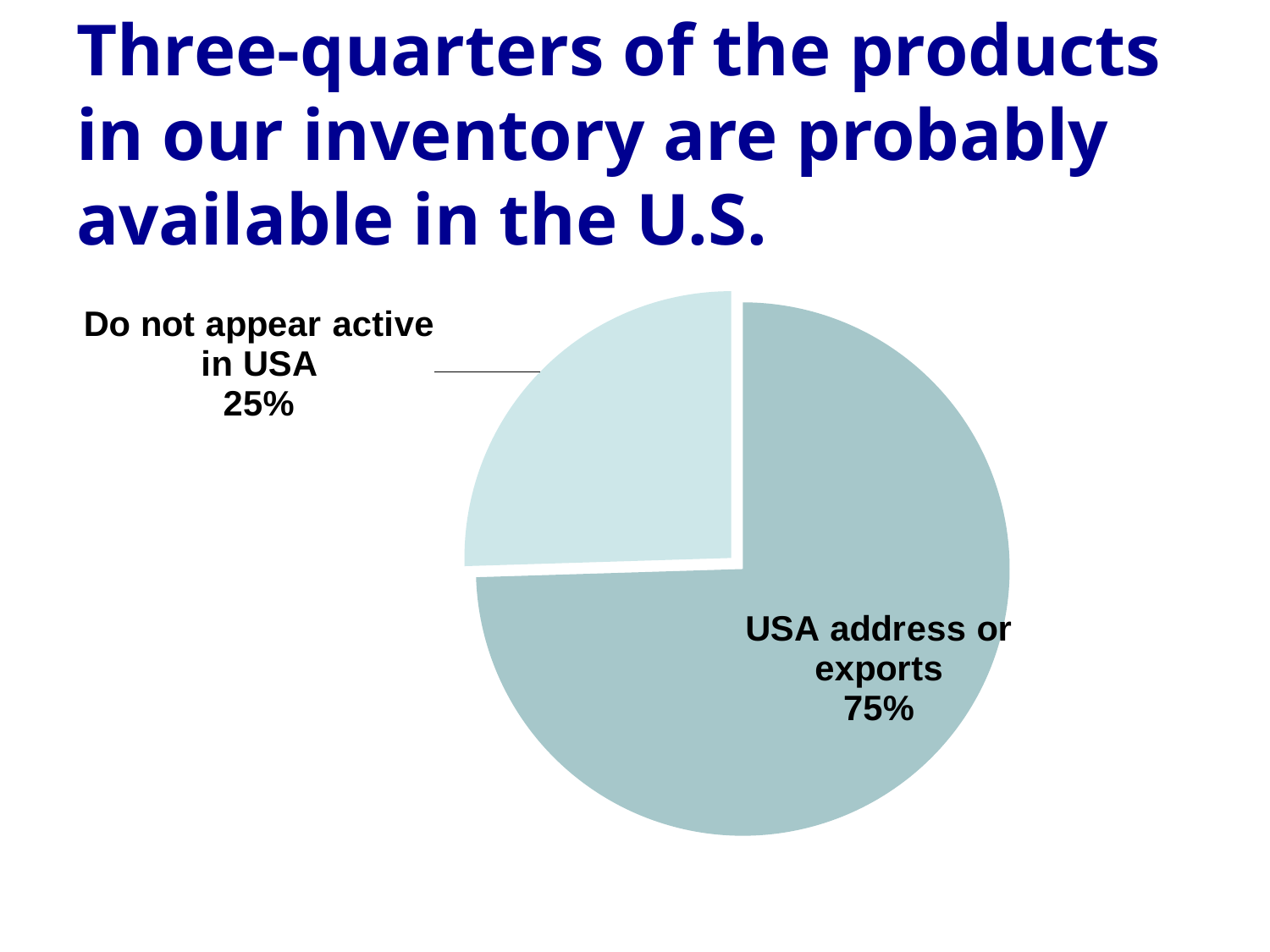
Which is larger: the "USA address or exports" slice or the "Do not appear active in USA" slice? USA address or exports What share of the pie is labelled "Do not appear active in USA"? 25% What is the difference in percentage points between the "USA address or exports" slice and the "Do not appear active in USA" slice? 50 percentage points Which slice of the pie is the largest? USA address or exports Which slice of the pie is pulled out (exploded) from the rest of the pie? Do not appear active in USA What share of the pie is labelled "USA address or exports"? 75% How many slices does the pie chart have? 2 What is the title of the slide containing the pie chart? Three-quarters of the products in our inventory are probably available in the U.S. Which slice of the pie is the smallest? Do not appear active in USA What kind of chart is shown on the slide? Pie chart